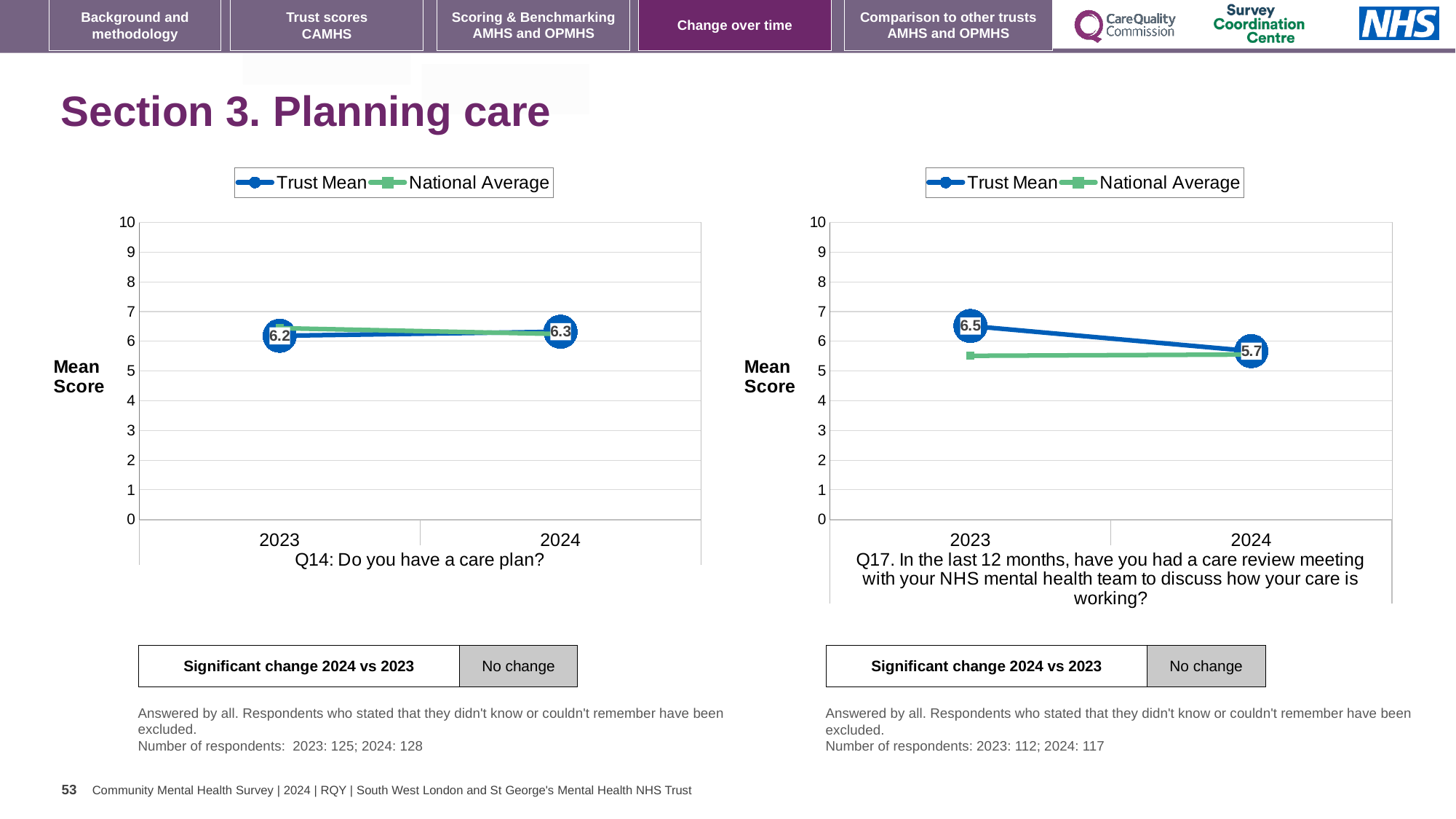
In the right chart (Q17, care review meeting), by how much did the Trust Mean fall from 2023 to 2024? 0.8 In the right chart (Q17, care review meeting), does the Trust Mean rise or fall from 2023 to 2024? fall In the right chart (Q17, care review meeting), is the National Average for 2023 greater or less than 6? less In the right chart (Q17, care review meeting), what is the Trust Mean score for 2024? 5.7 In the left chart (Q14: Do you have a care plan?), is the National Average for 2023 greater or less than 6? greater What kind of chart is the right chart (Q17, care review meeting)? line chart In the left chart (Q14: Do you have a care plan?), what is the Trust Mean score for 2024? 6.3 How many series does the legend of the left chart (Q14: Do you have a care plan?) list? 2 In the right chart (Q17, care review meeting), which is higher in 2023: the Trust Mean or the National Average? Trust Mean In the right chart (Q17, care review meeting), what is the Trust Mean score for 2023? 6.5 In the left chart (Q14: Do you have a care plan?), what is the difference between the Trust Mean for 2024 and 2023? 0.1 In the left chart (Q14: Do you have a care plan?), what is the Trust Mean score for 2023? 6.2